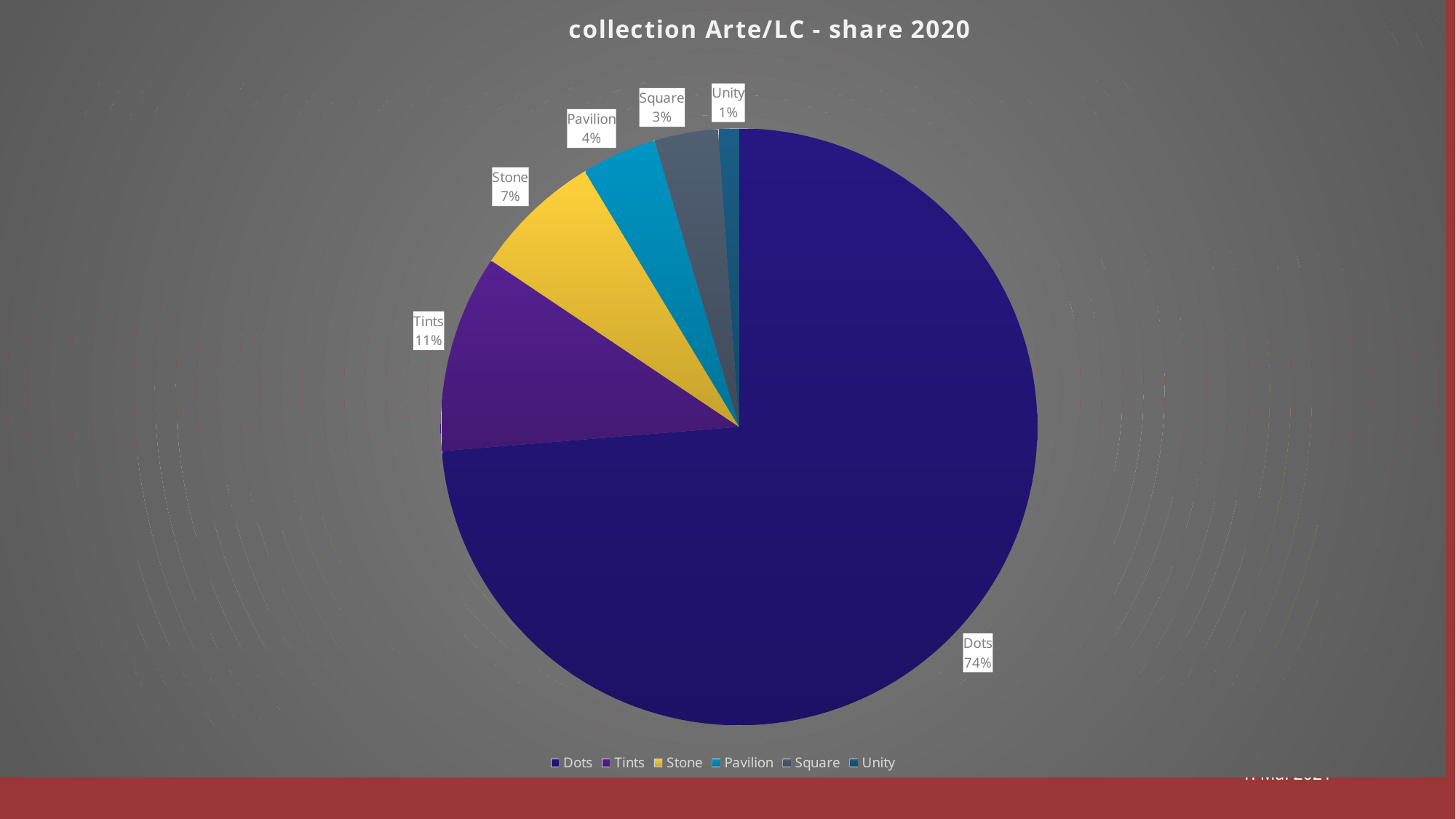
How many entries does the legend list? 6 Which category has the smallest slice? Unity What share does Tints have? 11% What is the difference in percentage points between Dots and Tints? 63 What share does Stone have? 7% What share does Dots have? 74% What share does Pavilion have? 4% What is the title of the chart? collection Arte/LC - share 2020 What kind of chart is shown on the slide? pie chart How many slices does the pie chart have? 6 Which is larger, Stone or Square? Stone Which category has the largest slice? Dots